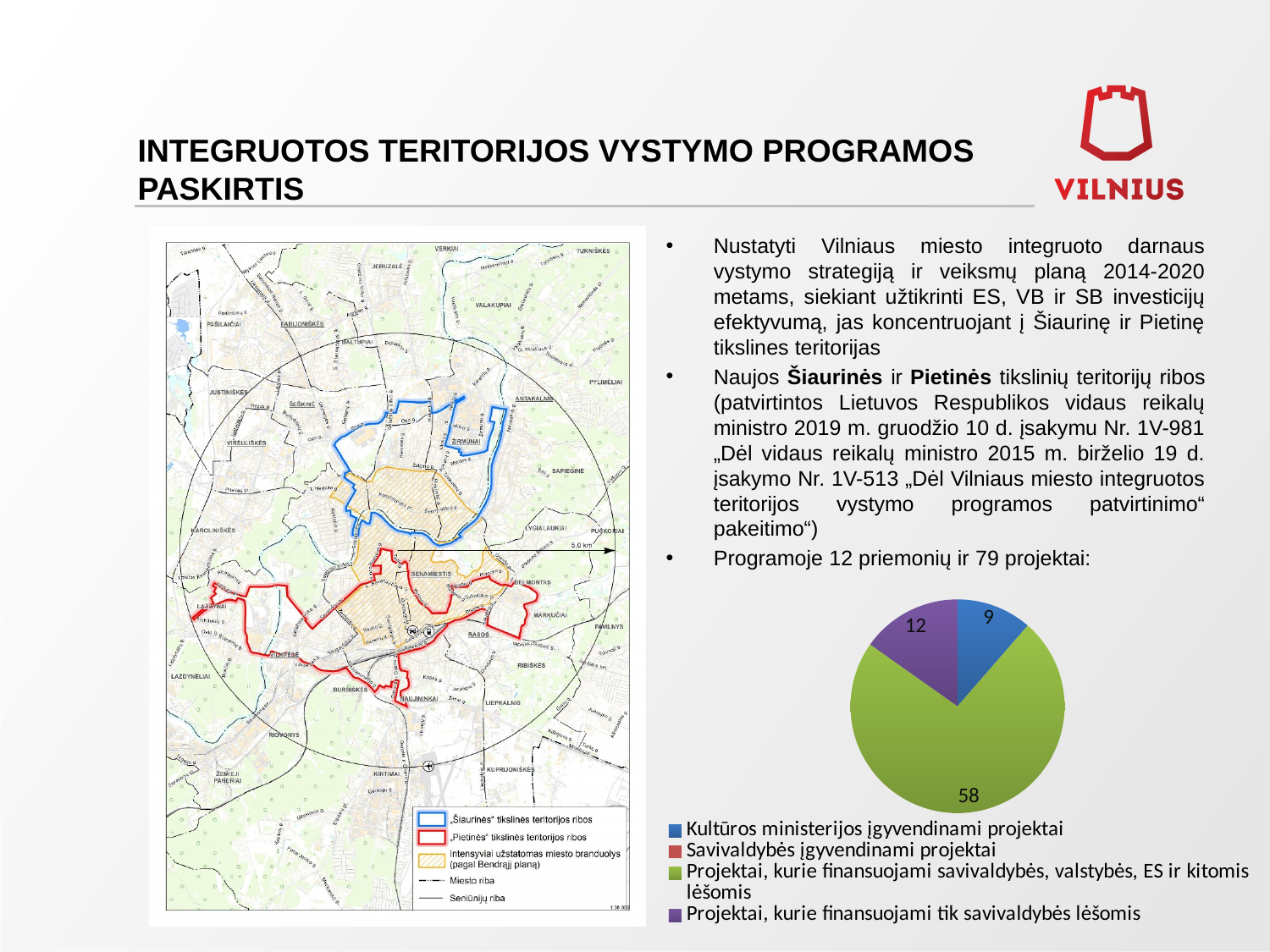
Which is larger: the 'Projektai, kurie finansuojami tik savivaldybės lėšomis' slice or the 'Kultūros ministerijos įgyvendinami projektai' slice? Projektai, kurie finansuojami tik savivaldybės lėšomis What value is shown for the 'Projektai, kurie finansuojami tik savivaldybės lėšomis' slice? 12 What is the difference between the slice valued 12 and the slice valued 9? 3 Which labelled slice in the pie chart has the smallest value? Kultūros ministerijos įgyvendinami projektai What colour is the slice representing 'Projektai, kurie finansuojami tik savivaldybės lėšomis'? purple How many projects are shown for the slice labelled 'Projektai, kurie finansuojami savivaldybės, valstybės, ES ir kitomis lėšomis'? 58 Which category has the largest slice in the pie chart? Projektai, kurie finansuojami savivaldybės, valstybės, ES ir kitomis lėšomis What type of chart is shown on the slide? pie chart What is the sum of the three values labelled on the pie chart (9, 58 and 12)? 79 How many entries does the pie chart legend list? 4 What is the difference between the largest slice (58) and the slice valued 12? 46 What value is shown for the 'Kultūros ministerijos įgyvendinami projektai' slice? 9